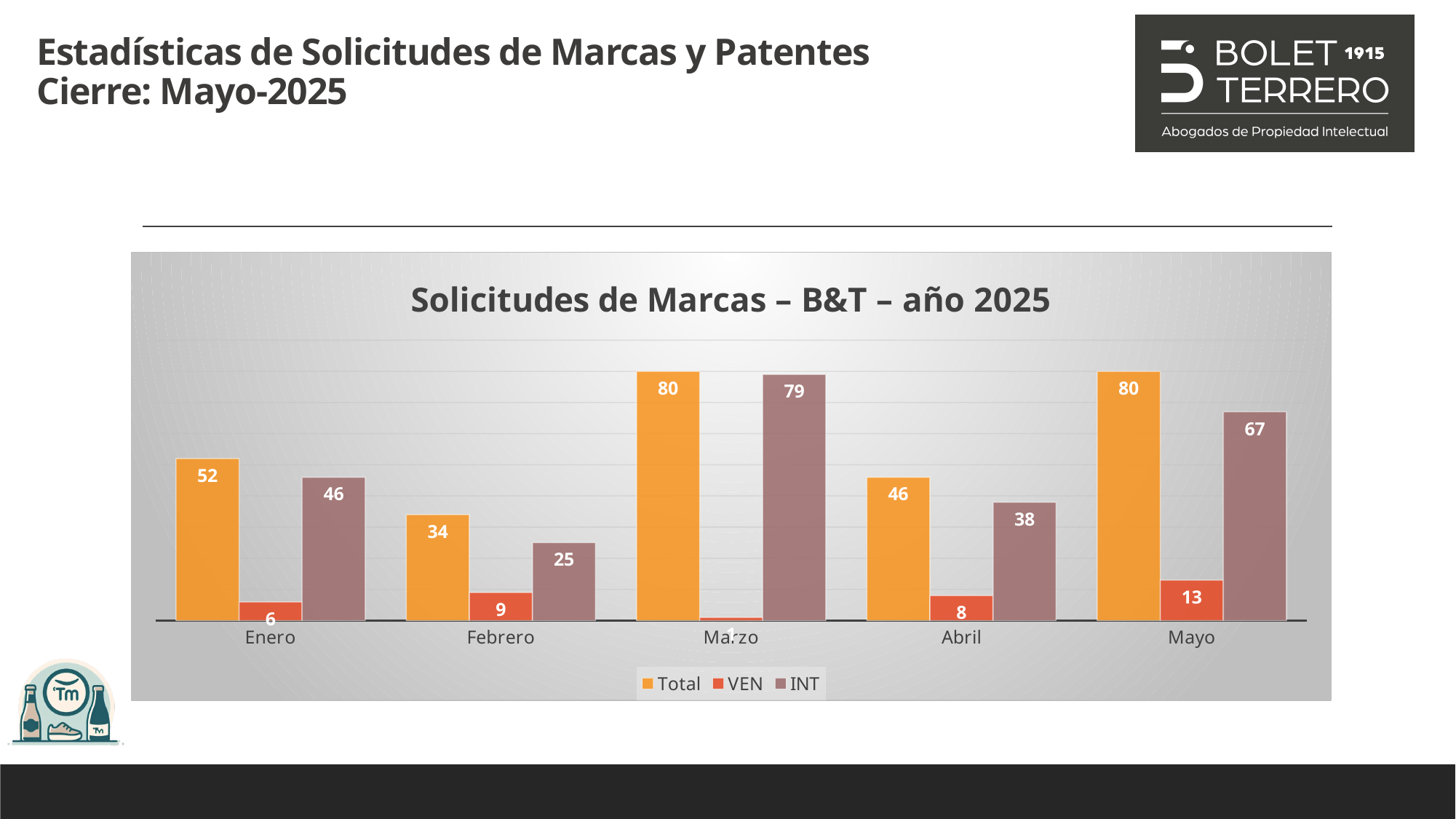
What is the INT value for Abril? 38 Which month has the highest VEN value? Mayo Which month has the lowest Total value? Febrero What kind of chart is shown on the slide? Bar chart What is the difference between the Total value for Marzo and the Total value for Febrero? 46 How many months are shown on the x axis? 5 Which month has the highest INT value? Marzo What is the Total value for Enero? 52 What is the VEN value for Febrero? 9 What is the INT value for Mayo? 67 Which is larger, the INT value for Enero or the INT value for Abril? INT value for Enero How many series does the legend list? 3